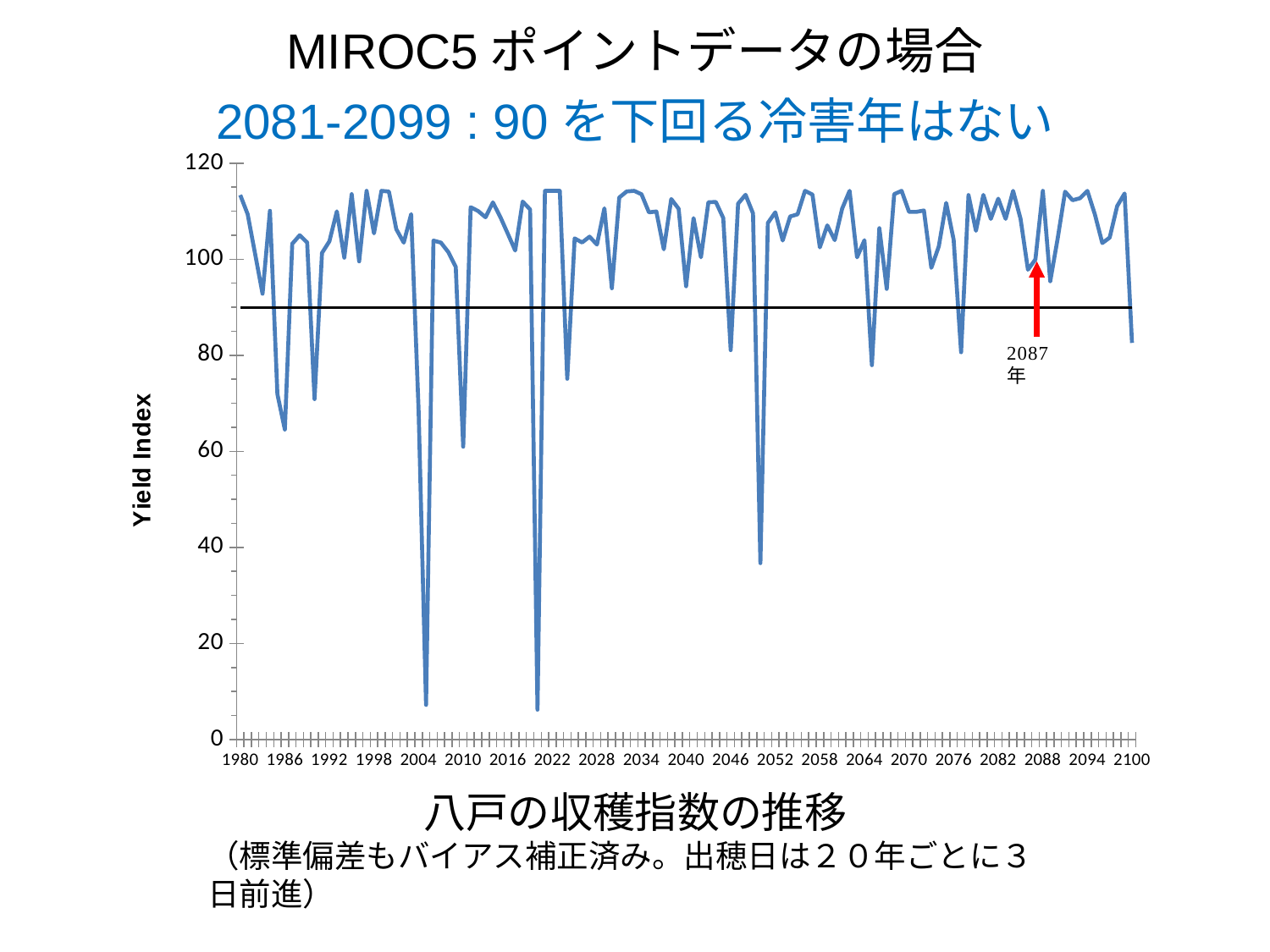
Is the Yield Index value at the deep dip around 2005 greater or less than 20? less Is the Yield Index value for 2087 greater or less than 90? greater Which year is marked by the red arrow on the chart? 2087 Is the Yield Index value for 1980 greater or less than 100? greater What is the first year shown on the horizontal axis of the chart? 1980 What kind of chart is shown on the slide? line chart What is the label of the vertical axis of the chart? Yield Index At what Yield Index value is the horizontal reference line drawn across the chart? 90 What is the last year shown on the horizontal axis of the chart? 2100